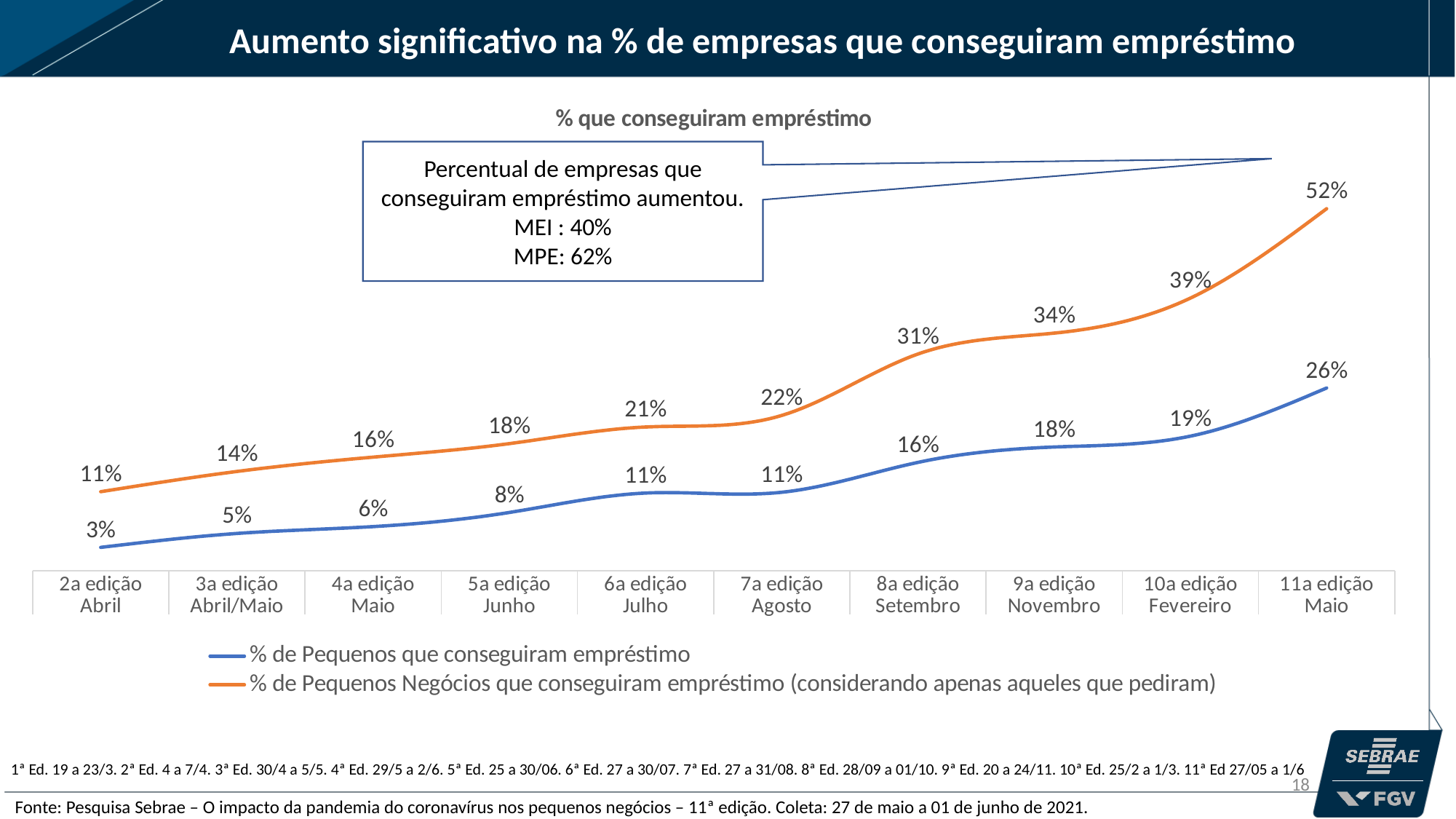
What type of chart is shown on the slide? line chart What is the difference between the two series at 11a edição Maio? 26% What is the value of '% de Pequenos que conseguiram empréstimo' at 2a edição Abril? 3% What is the value of '% de Pequenos Negócios que conseguiram empréstimo (considerando apenas aqueles que pediram)' at 8a edição Setembro? 31% How many series does the legend list? 2 At which edition is the blue series '% de Pequenos que conseguiram empréstimo' lowest? 2a edição Abril Do the values of the orange series rise or fall from 2a edição Abril to 11a edição Maio? rise What is the title of the chart? % que conseguiram empréstimo How many editions (categories) are shown on the x axis? 10 At which edition is the orange series '% de Pequenos Negócios que conseguiram empréstimo (considerando apenas aqueles que pediram)' highest? 11a edição Maio What is the value of '% de Pequenos que conseguiram empréstimo' at 11a edição Maio? 26% Which series has the larger value at 5a edição Junho? % de Pequenos Negócios que conseguiram empréstimo (considerando apenas aqueles que pediram)